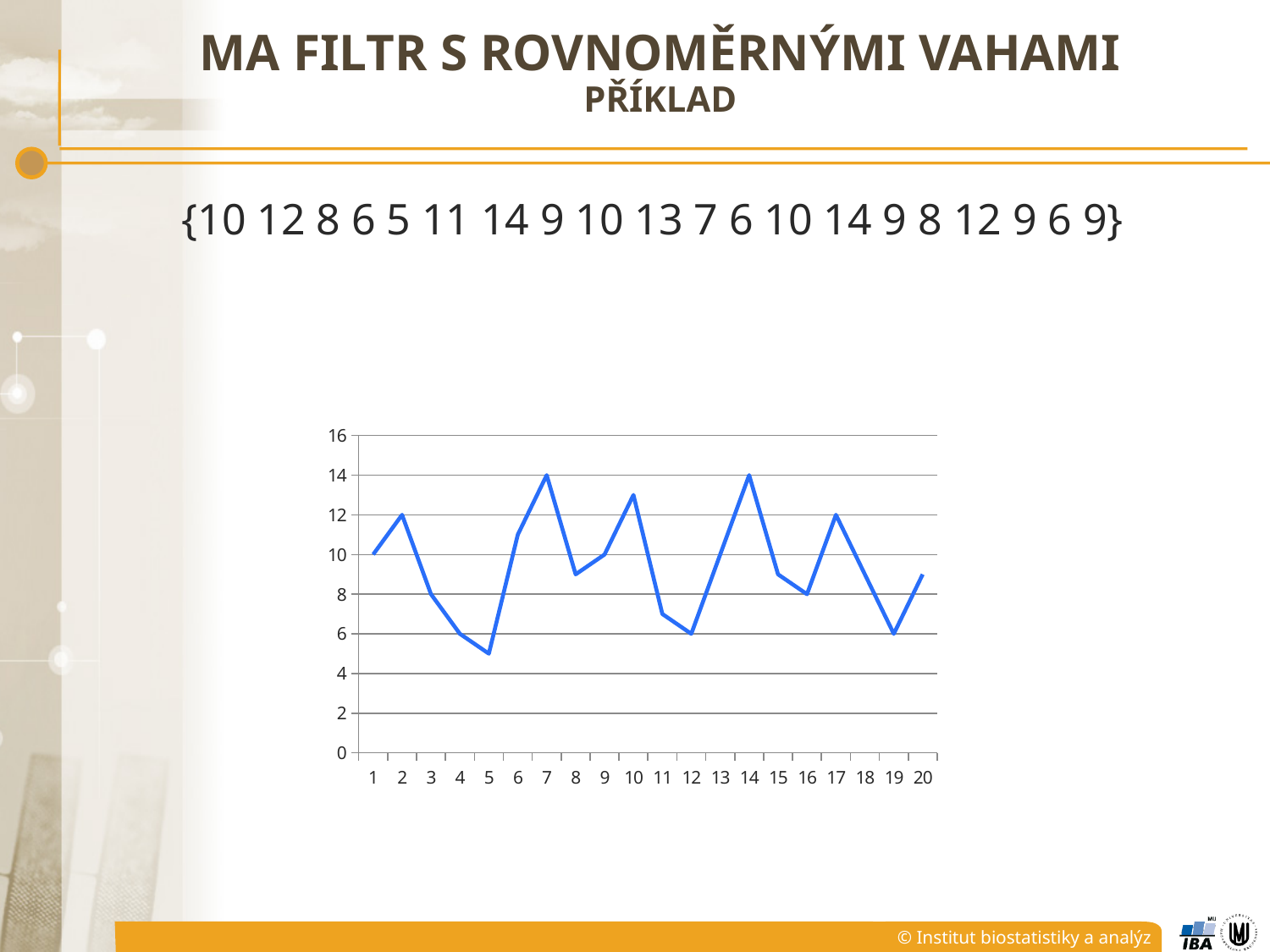
At which point does the chart reach its lowest value? 5 What kind of chart is shown on the slide? line chart Is the value at point 6 greater or less than 10? greater Is the value at point 11 greater or less than 8? less How many data points are plotted on the x axis of the chart? 20 Which is larger, the value at point 7 or the value at point 8? point 7 What is the lowest value plotted on the chart? 5 What is the value at point 7 on the chart? 14 What is the value at point 1 on the chart? 10 What is the difference between the value at point 2 and the value at point 5? 7 What is the value at point 19 on the chart? 6 What is the value at point 2 on the chart? 12